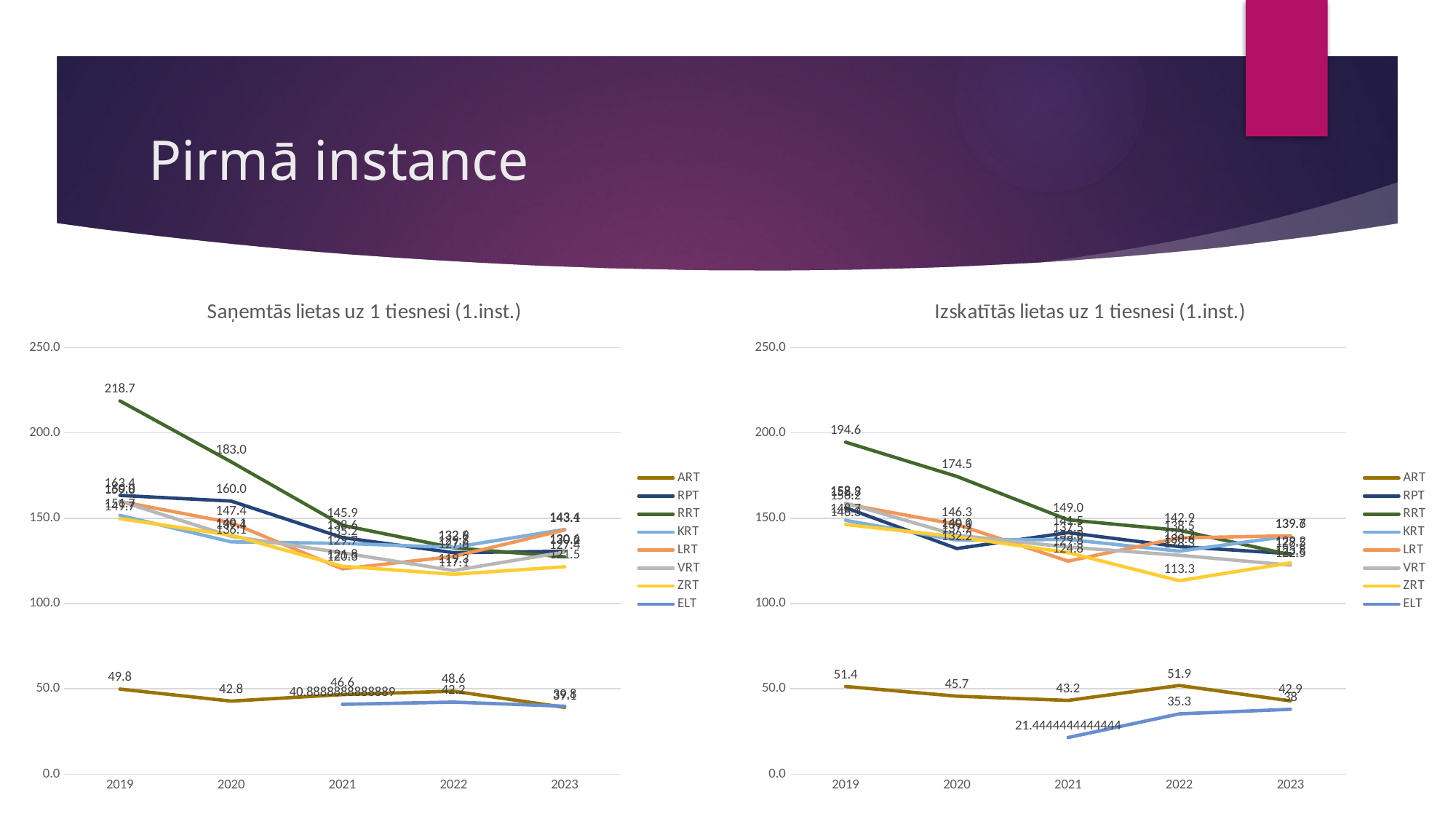
In the 'Izskatītās lietas uz 1 tiesnesi (1.inst.)' chart, what is the value for ZRT in 2022? 113.3 How many series does the legend of the 'Izskatītās lietas uz 1 tiesnesi (1.inst.)' chart list? 8 In the 'Izskatītās lietas uz 1 tiesnesi (1.inst.)' chart, what is the value for ART in 2022? 51.9 What kind of chart is the 'Saņemtās lietas uz 1 tiesnesi (1.inst.)' chart? line chart In the 'Saņemtās lietas uz 1 tiesnesi (1.inst.)' chart, by how much did RRT fall from 2019 to 2020? 35.7 In the 'Izskatītās lietas uz 1 tiesnesi (1.inst.)' chart, does the RRT line rise or fall from 2019 to 2023? fall In the 'Saņemtās lietas uz 1 tiesnesi (1.inst.)' chart, which series has the highest value in 2019? RRT In the 'Saņemtās lietas uz 1 tiesnesi (1.inst.)' chart, what is the value for RRT in 2019? 218.7 In the 'Saņemtās lietas uz 1 tiesnesi (1.inst.)' chart, what is the value for RRT in 2020? 183.0 In the 'Izskatītās lietas uz 1 tiesnesi (1.inst.)' chart, what is the value for RRT in 2019? 194.6 How many years are shown on the x axis of the 'Saņemtās lietas uz 1 tiesnesi (1.inst.)' chart? 5 In the 'Izskatītās lietas uz 1 tiesnesi (1.inst.)' chart, which is larger: ART in 2019 or ELT in 2023? ART in 2019